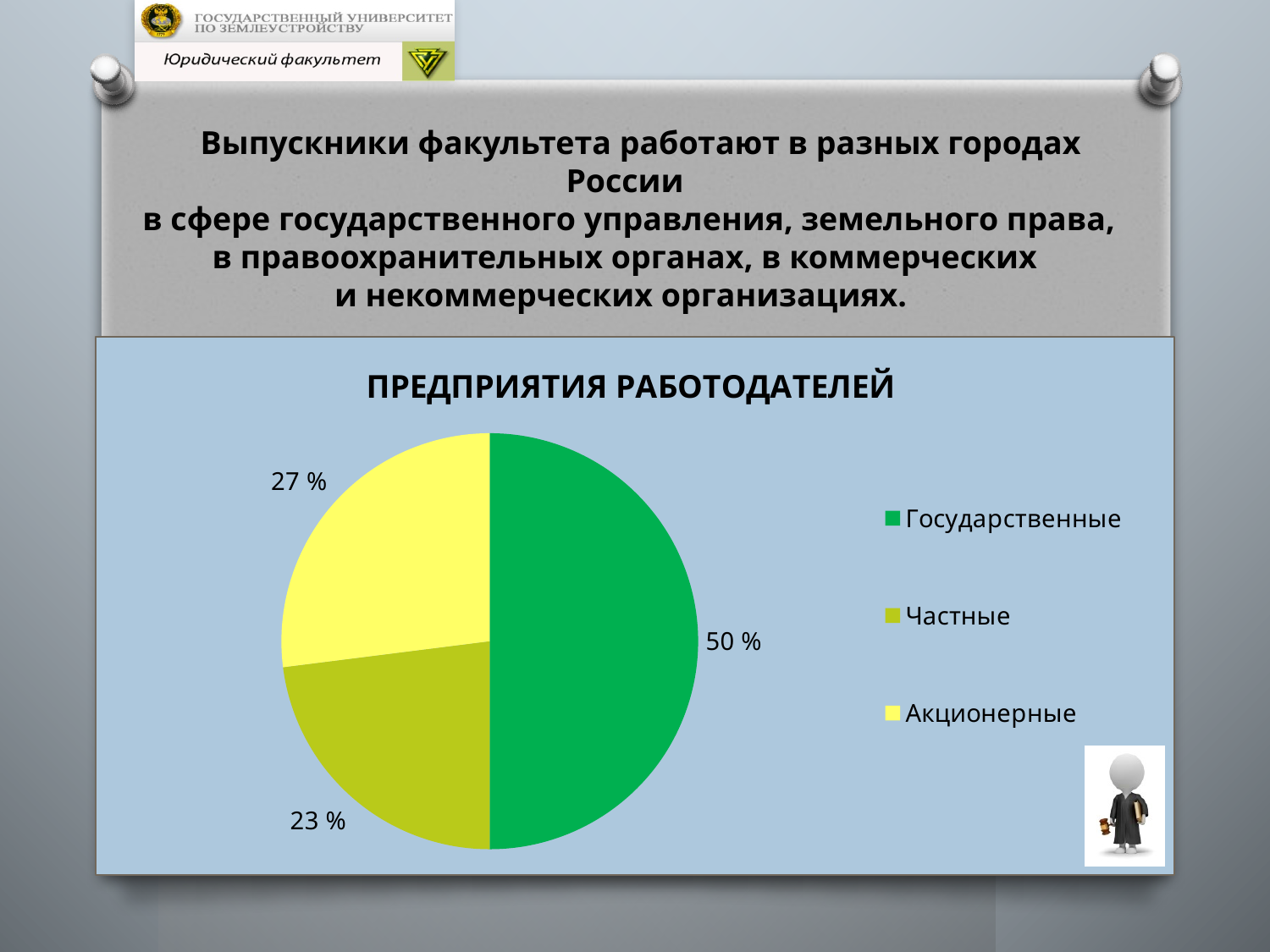
What is the difference in percentage points between the Государственные share and the Акционерные share? 23 What share of the pie is labelled for Частные? 23 % How many entries does the legend list? 3 Which is larger, the share for Акционерные or the share for Частные? Акционерные What share of the pie is labelled for Акционерные? 27 % What colour is the slice for Акционерные? yellow What share of the pie is labelled for Государственные? 50 % What kind of chart is shown on the slide? pie chart Which category has the smallest slice of the pie? Частные How many categories does the pie chart show? 3 What is the title of the chart? ПРЕДПРИЯТИЯ РАБОТОДАТЕЛЕЙ Which category has the largest slice of the pie? Государственные